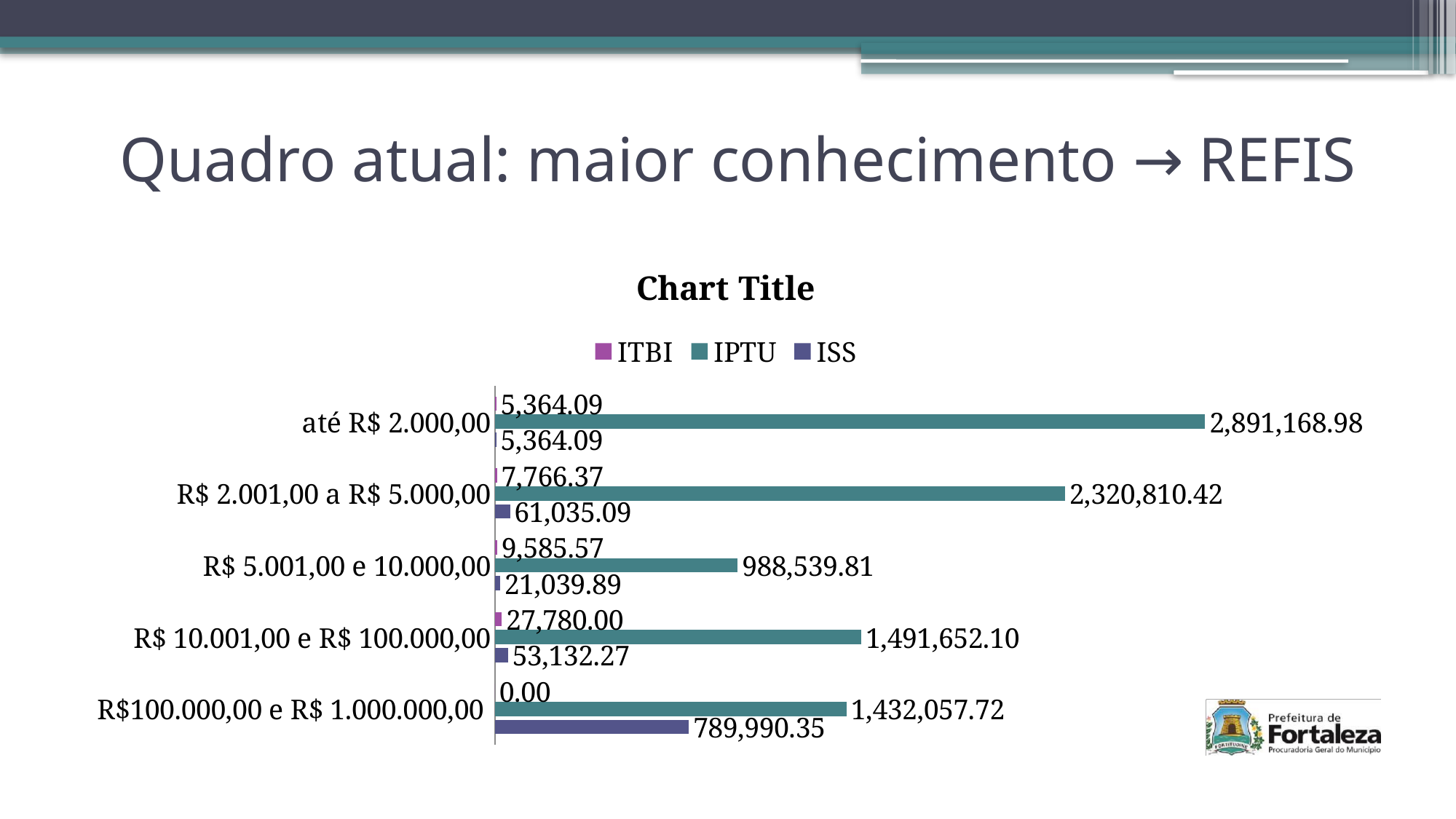
Which category has the highest IPTU value? até R$ 2.000,00 What is the difference between the IPTU values for 'até R$ 2.000,00' and 'R$ 2.001,00 a R$ 5.000,00'? 570,358.56 Which is larger: the ISS value for 'R$ 2.001,00 a R$ 5.000,00' or the ISS value for 'R$ 10.001,00 e R$ 100.000,00'? R$ 2.001,00 a R$ 5.000,00 What is the IPTU value for the category 'R$ 5.001,00 e 10.000,00'? 988,539.81 What is the IPTU value for the category 'até R$ 2.000,00'? 2,891,168.98 What is the ITBI value for the category 'R$ 10.001,00 e R$ 100.000,00'? 27,780.00 What is the ISS value for the category 'R$100.000,00 e R$ 1.000.000,00'? 789,990.35 How many series does the legend list? 3 What type of chart is shown on the slide? bar chart Which category has the lowest IPTU value? R$ 5.001,00 e 10.000,00 How many categories are shown on the chart? 5 Which category has the lowest ITBI value? R$100.000,00 e R$ 1.000.000,00